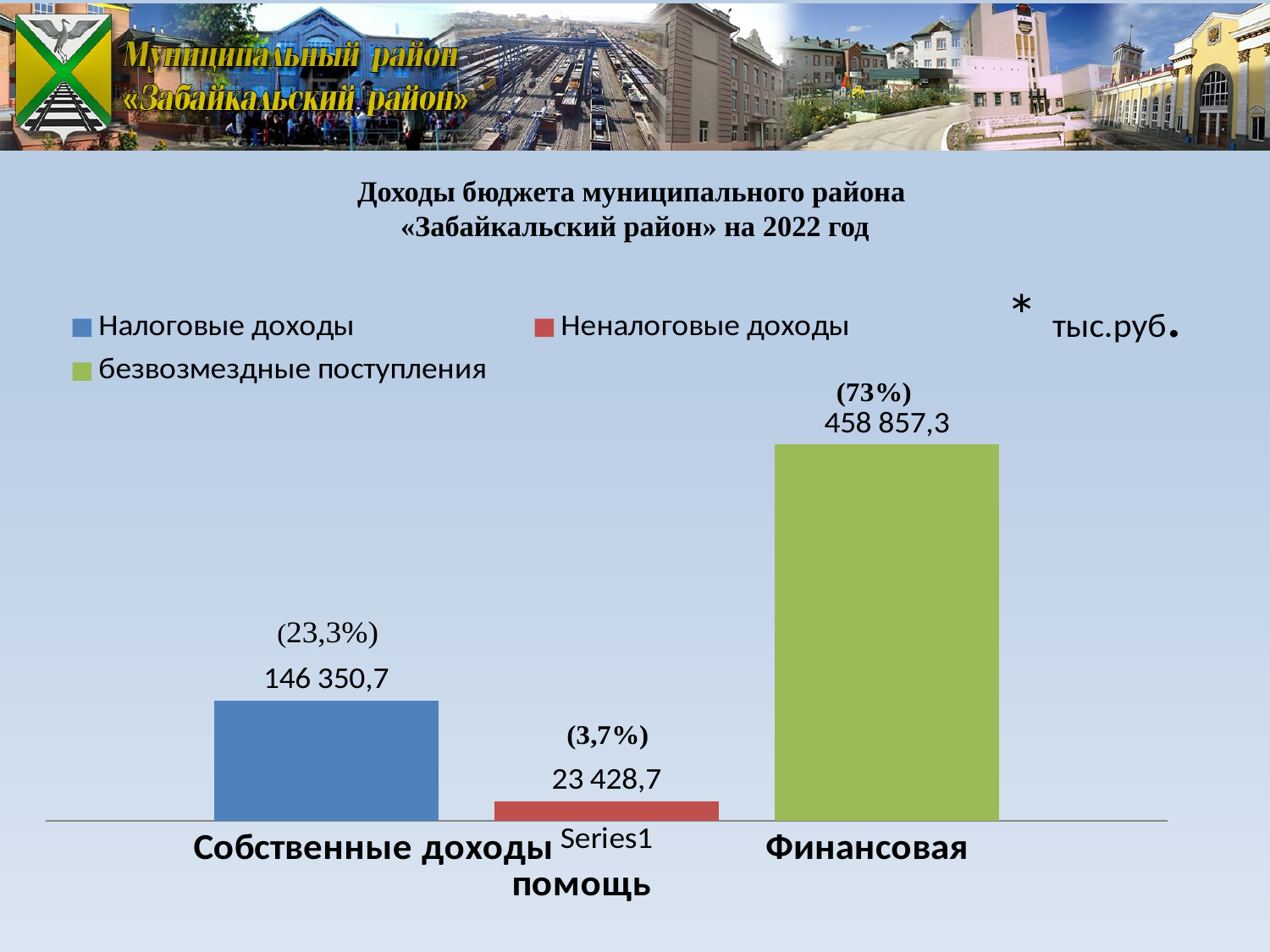
How many series does the legend list? 3 Which series has the highest value? безвозмездные поступления What is the value shown for Неналоговые доходы? 23 428,7 What is the value shown for безвозмездные поступления? 458 857,3 Which series has the lowest value? Неналоговые доходы What percentage share is printed above the bar for безвозмездные поступления? (73%) What kind of chart is shown on the slide? bar chart What is the difference between Налоговые доходы and Неналоговые доходы? 122 922,0 What is the value shown for Налоговые доходы? 146 350,7 What percentage share is printed above the bar for Налоговые доходы? (23,3%) What is the difference between безвозмездные поступления and Налоговые доходы? 312 506,6 Which is larger, Налоговые доходы or Неналоговые доходы? Налоговые доходы